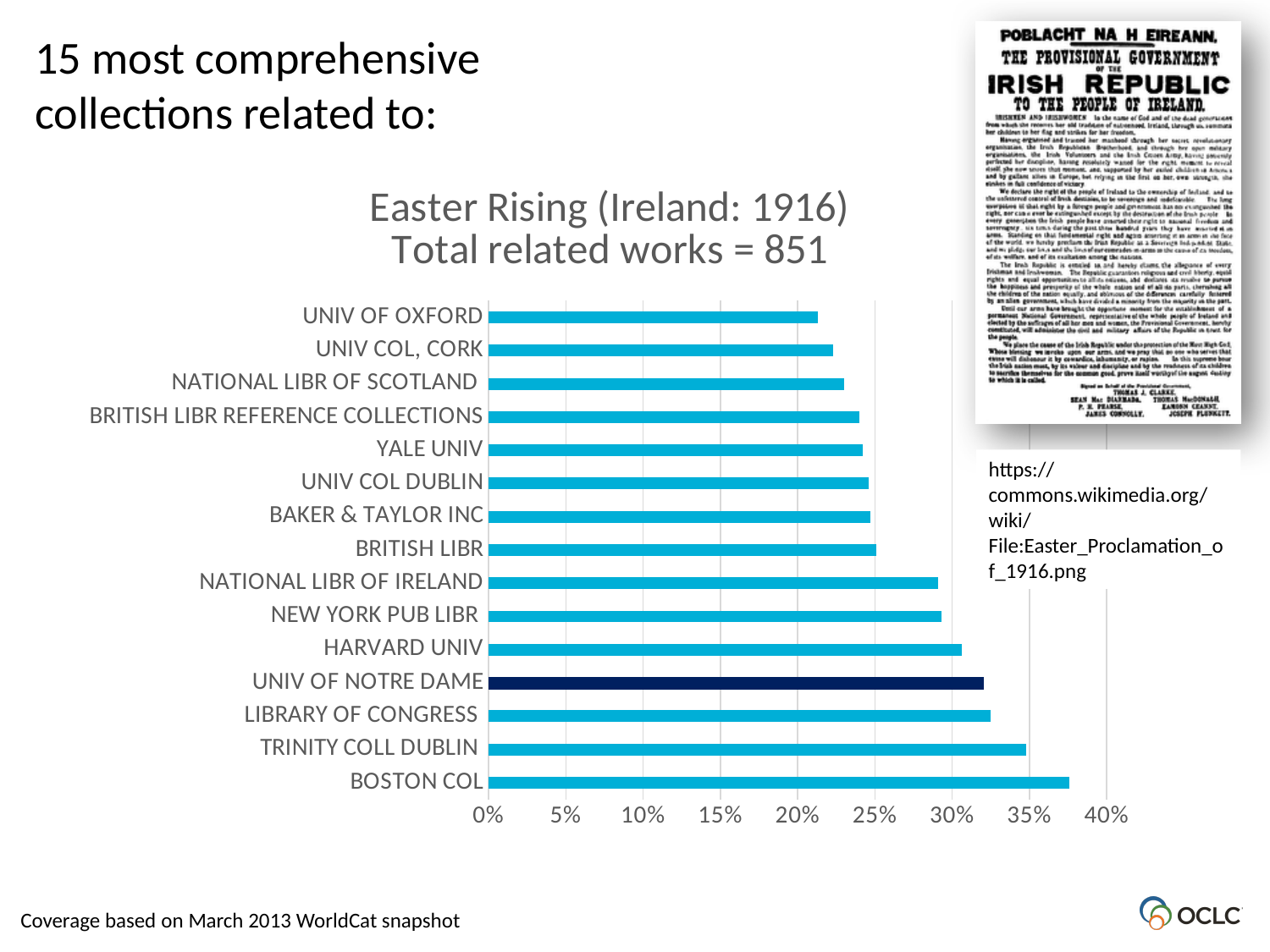
Is the value for UNIV OF OXFORD greater or less than 20%? greater Is the value for BOSTON COL greater or less than 35%? greater Which institution's bar is highlighted in dark blue in the chart? UNIV OF NOTRE DAME Which institution has the highest value in the chart? BOSTON COL Is the value for UNIV OF NOTRE DAME greater or less than 30%? greater What kind of chart is shown on the slide? Bar chart Which institution has the lowest value in the chart? UNIV OF OXFORD How many institutions are listed in the chart? 15 Which has a larger value, BOSTON COL or TRINITY COLL DUBLIN? BOSTON COL Which has a larger value, HARVARD UNIV or UNIV OF OXFORD? HARVARD UNIV